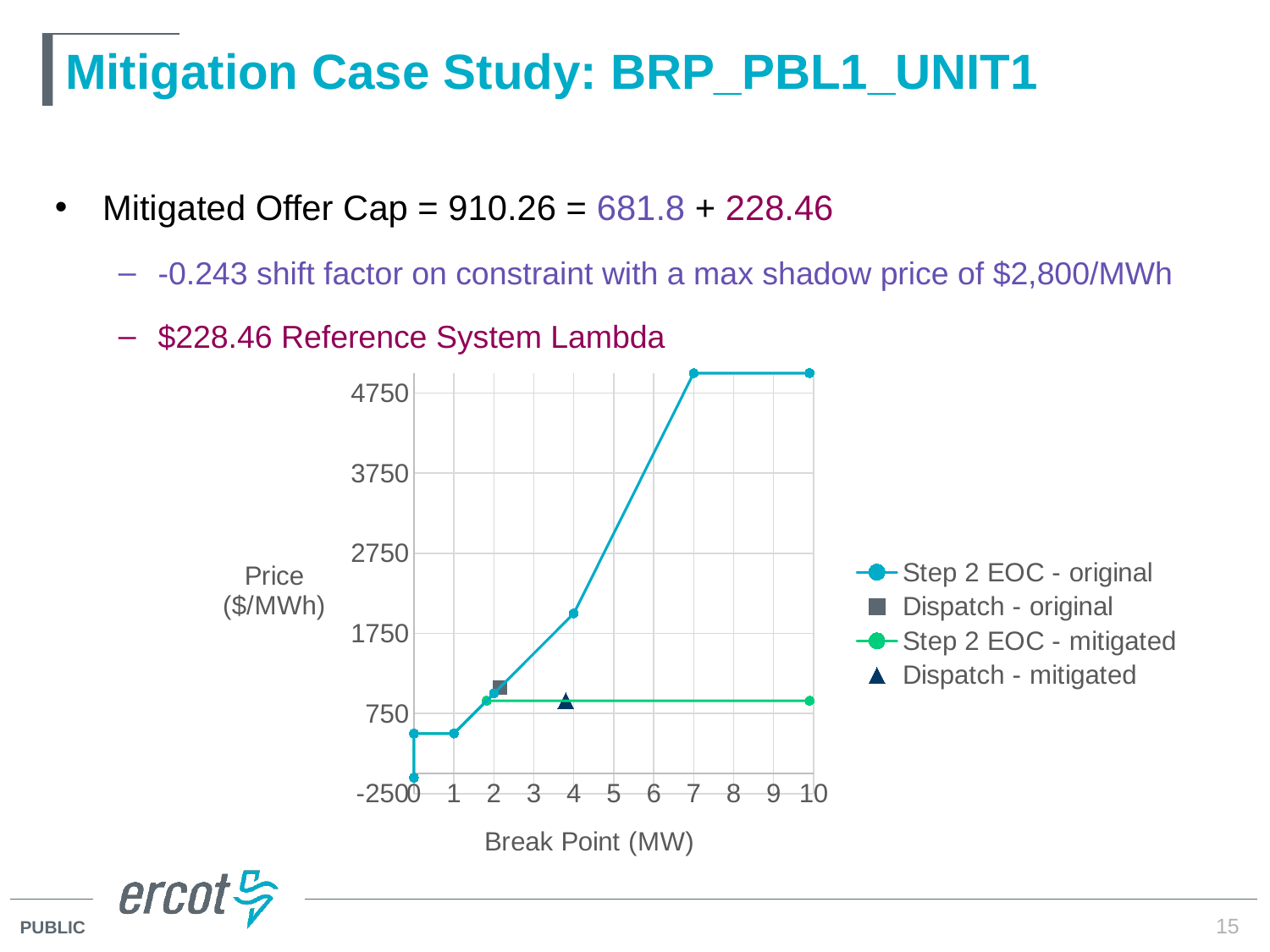
Is the value of Step 2 EOC - original at break point 4 greater or less than 1750? greater Is the value of Step 2 EOC - original at break point 10 greater or less than 4750? greater What is the title of the x axis of the chart? Break Point (MW) What is the title of the y axis of the chart? Price ($/MWh) Is the value of Step 2 EOC - mitigated at break point 6 greater or less than 750? greater At break point 10, which series has the higher price: Step 2 EOC - original or Step 2 EOC - mitigated? Step 2 EOC - original What kind of chart is shown on the slide? line chart Does the Step 2 EOC - original series rise or fall as the break point increases from 1 to 7? rise How many series does the chart legend list? 4 Which series reaches the highest price on the chart? Step 2 EOC - original